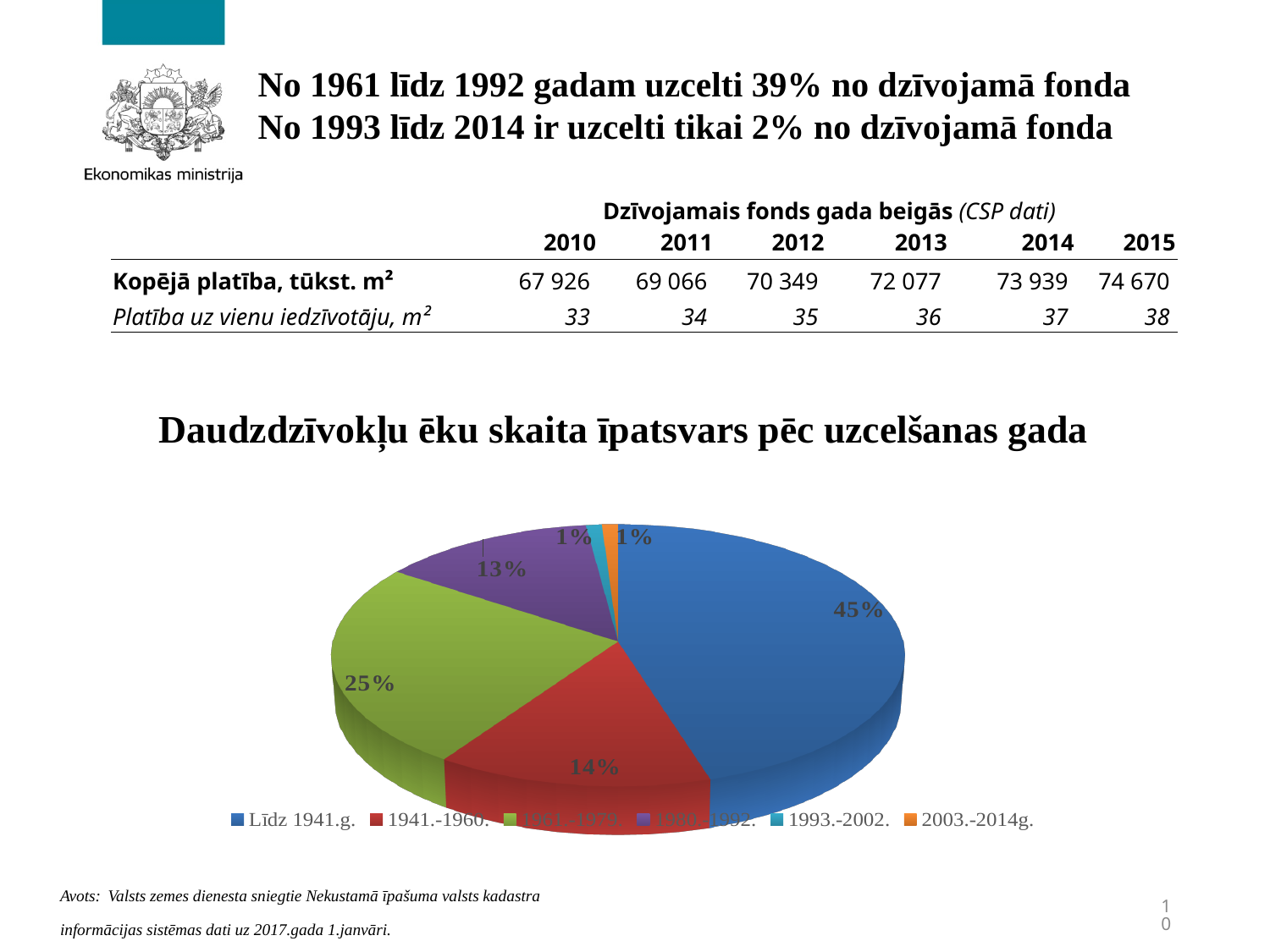
How many entries does the legend of the pie chart list? 6 Which category has the largest slice of the pie? Līdz 1941.g. What kind of chart is shown on the slide? pie chart What share of the pie does the '1941.-1960.' slice represent? 14% What is the difference in percentage points between the 'Līdz 1941.g.' slice and the '1941.-1960.' slice? 31 What share of the pie does the 'Līdz 1941.g.' slice represent? 45% What share of the pie does the '2003.-2014g.' slice represent? 1% How many slices does the pie chart have? 6 What is the title of the pie chart? Daudzdzīvokļu ēku skaita īpatsvars pēc uzcelšanas gada Which slice is larger: 'Līdz 1941.g.' or '1941.-1960.'? Līdz 1941.g. What colour is the 'Līdz 1941.g.' slice in the pie chart? blue